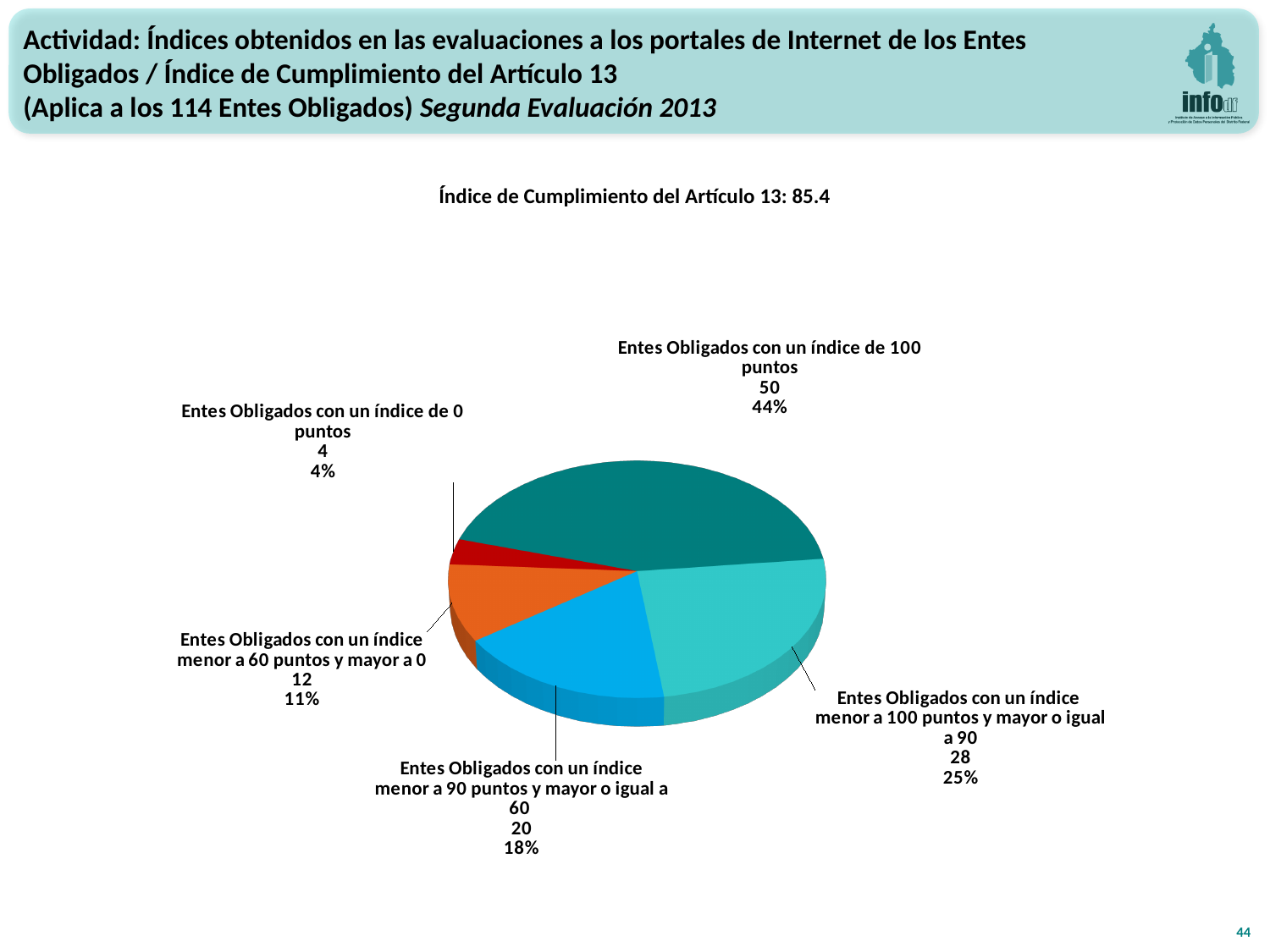
What is the Índice de Cumplimiento del Artículo 13 stated above the chart? 85.4 What percentage of the pie corresponds to Entes Obligados with an index of 100 points? 44% Which is larger: the number of Entes Obligados with an index less than 60 points and greater than 0, or those with an index less than 90 points and greater than or equal to 60? Entes Obligados con un índice menor a 90 puntos y mayor o igual a 60 Which category has the largest slice of the pie? Entes Obligados con un índice de 100 puntos What share of the pie is for Entes Obligados with an index less than 90 points and greater than or equal to 60? 18% How many Entes Obligados have an index less than 100 points and greater than or equal to 90? 28 How many Entes Obligados have an index of 100 points? 50 What kind of chart is shown on the slide? pie chart How many slices does the pie chart have? 5 How many Entes Obligados have an index of 0 points? 4 What is the difference between the number of Entes Obligados with an index of 100 points and those with an index less than 100 and greater than or equal to 90? 22 Which category has the smallest slice of the pie? Entes Obligados con un índice de 0 puntos